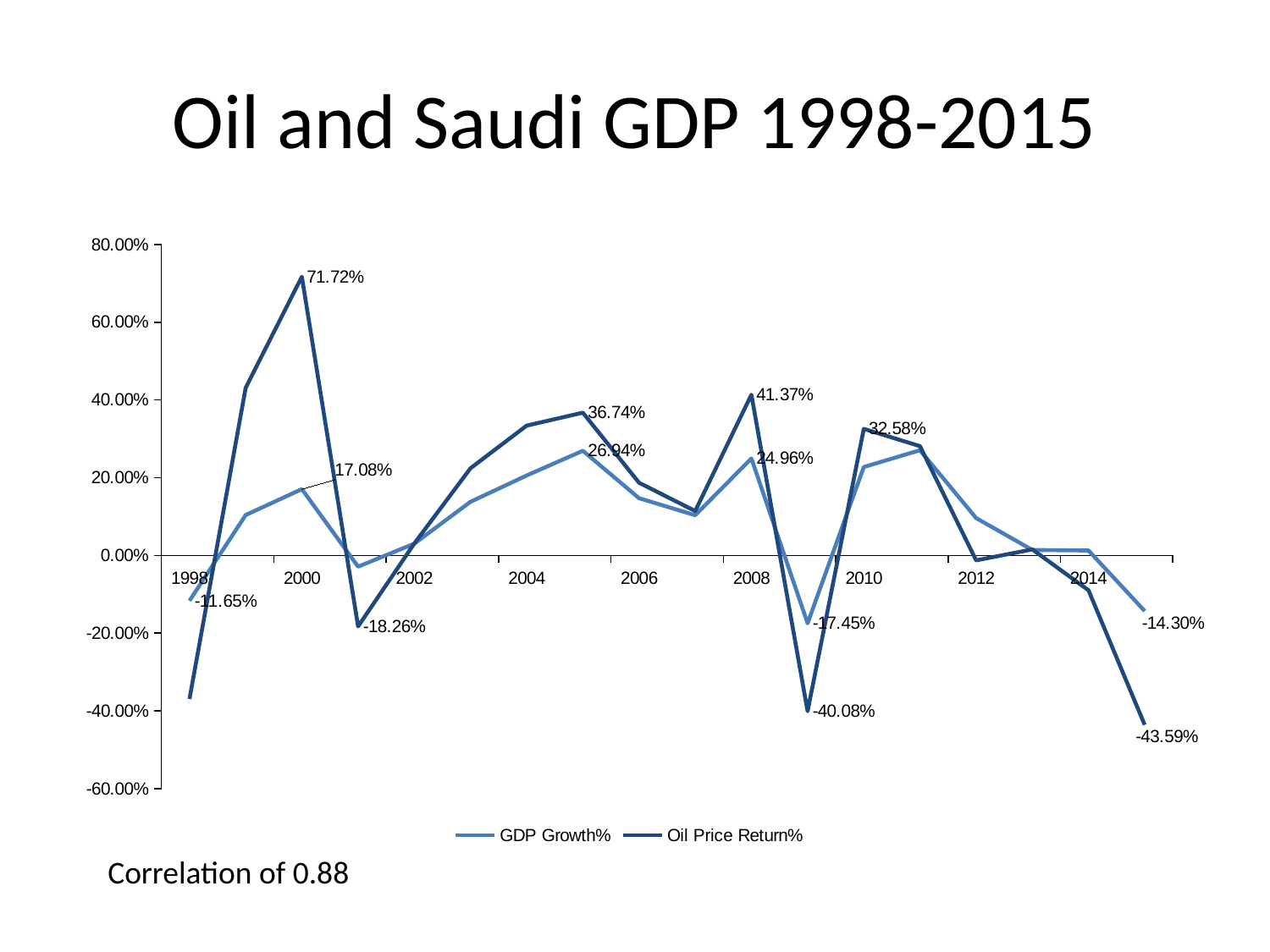
In which year does Oil Price Return% reach its highest value? 2000 What is the difference between Oil Price Return% and GDP Growth% in 2000? 54.64 percentage points What correlation value is stated below the chart? 0.88 What is the GDP Growth% value in 2015? -14.30% What is the Oil Price Return% value in 2000? 71.72% What is the GDP Growth% value in 2000? 17.08% What kind of chart is shown on the slide? line chart In 2008, which is larger: Oil Price Return% or GDP Growth%? Oil Price Return% In which year does Oil Price Return% reach its lowest value? 2015 Is the Oil Price Return% value in 1998 greater or less than -20.00%? less What is the Oil Price Return% value in 2009? -40.08% How many series does the legend list? 2